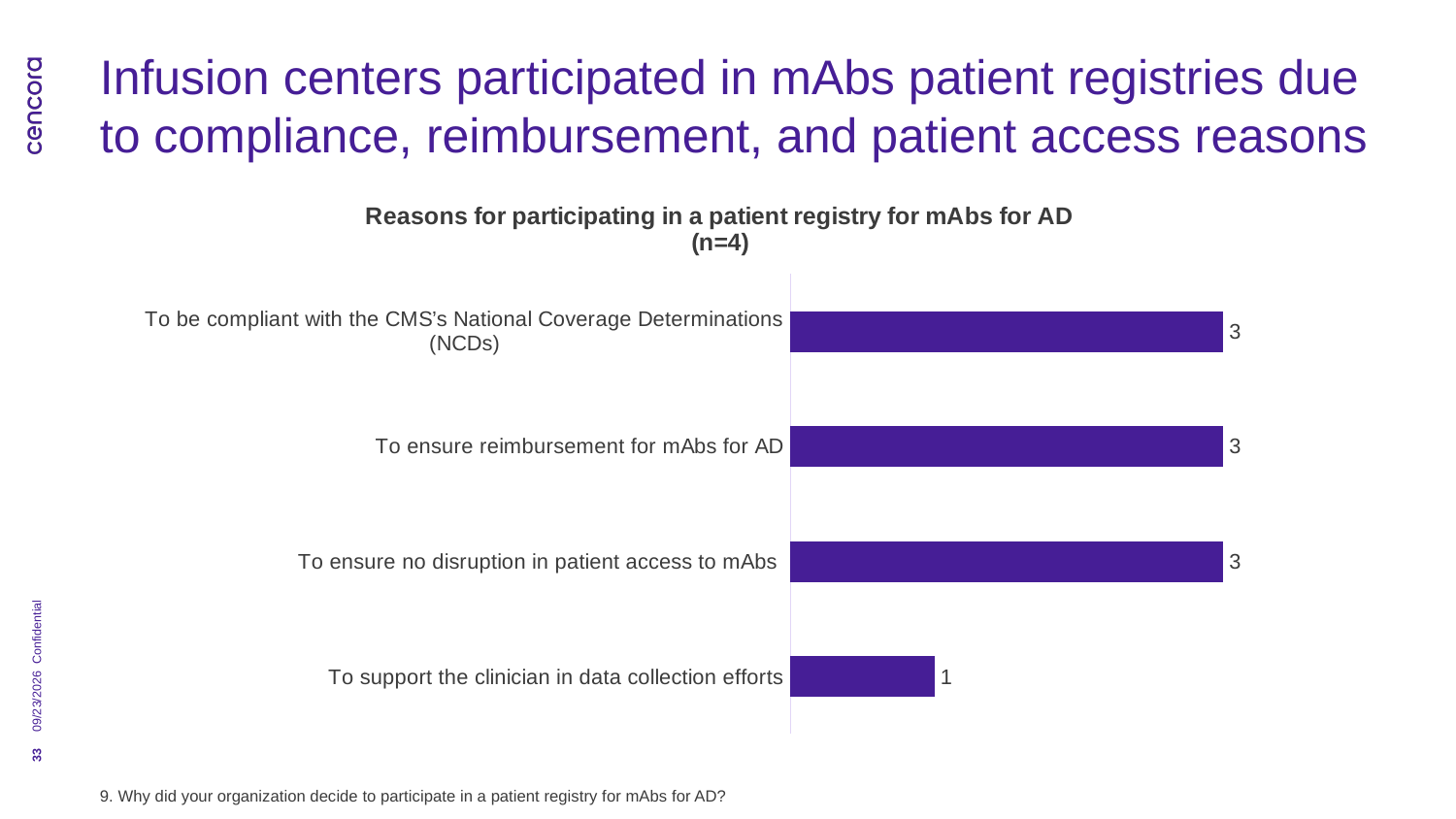
What is the value for "To be compliant with the CMS's National Coverage Determinations (NCDs)"? 3 What kind of chart is shown on the slide? Bar chart What is the value for "To ensure reimbursement for mAbs for AD"? 3 What is the value for "To ensure no disruption in patient access to mAbs"? 3 Which reason has the lowest value? To support the clinician in data collection efforts What is the title of the chart? Reasons for participating in a patient registry for mAbs for AD (n=4) What is the sample size (n) stated in the chart title? 4 What is the difference between the value for "To ensure reimbursement for mAbs for AD" and the value for "To support the clinician in data collection efforts"? 2 How many reasons (categories) are shown in the chart? 4 What is the value for "To support the clinician in data collection efforts"? 1 Which is larger: the value for "To ensure no disruption in patient access to mAbs" or the value for "To support the clinician in data collection efforts"? To ensure no disruption in patient access to mAbs How many reasons have a value of 3? 3